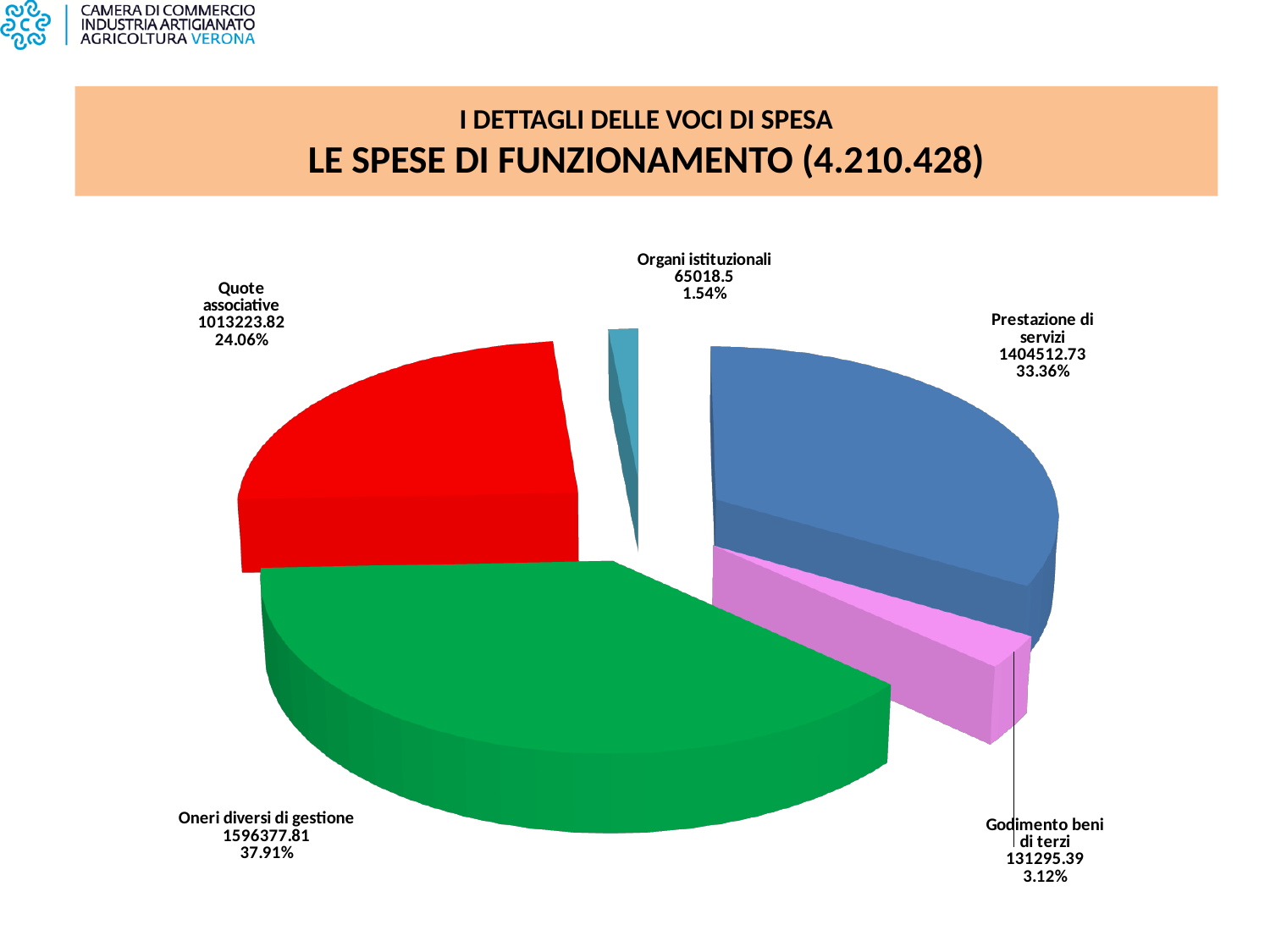
Which category has the largest slice? Oneri diversi di gestione Which category has the smallest slice? Organi istituzionali Which is larger, Godimento beni di terzi or Organi istituzionali? Godimento beni di terzi What is the difference between the values for Oneri diversi di gestione and Prestazione di servizi? 191865.08 What percentage share does Quote associative have? 24.06% How many slices does the pie chart have? 5 What kind of chart is shown on the slide? pie chart What is the value for Prestazione di servizi? 1404512.73 What total amount is shown in the slide title for Le spese di funzionamento? 4.210.428 What is the value for Organi istituzionali? 65018.5 What is the difference in percentage share between Oneri diversi di gestione and Prestazione di servizi? 4.55% What percentage share does Oneri diversi di gestione have? 37.91%